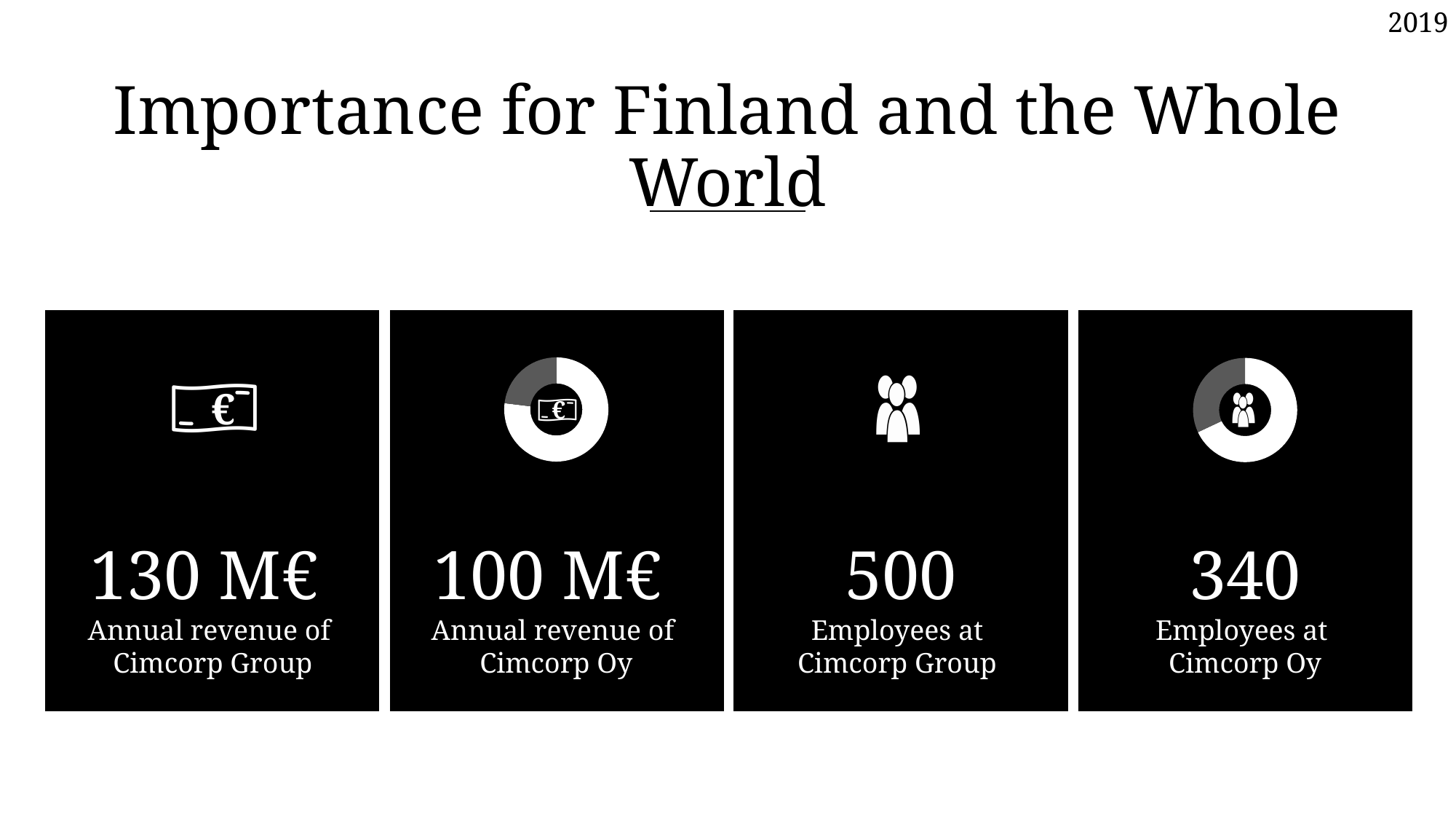
What is the title of the slide? Importance for Finland and the Whole World How many employees are at Cimcorp Group according to the slide? 500 Which is larger, the annual revenue of Cimcorp Group or the annual revenue of Cimcorp Oy? Cimcorp Group What year is shown in the top right corner of the slide? 2019 How many employees are at Cimcorp Oy according to the slide? 340 What kind of chart is shown in the tile for the annual revenue of Cimcorp Oy? Donut (pie) chart What is the annual revenue of Cimcorp Group shown on the slide? 130 M€ What is the annual revenue of Cimcorp Oy shown on the slide? 100 M€ Which has more employees, Cimcorp Group or Cimcorp Oy? Cimcorp Group What is the difference between the number of employees at Cimcorp Group and at Cimcorp Oy? 160 How many donut charts appear on the slide? 2 What is the difference between the annual revenue of Cimcorp Group and the annual revenue of Cimcorp Oy? 30 M€